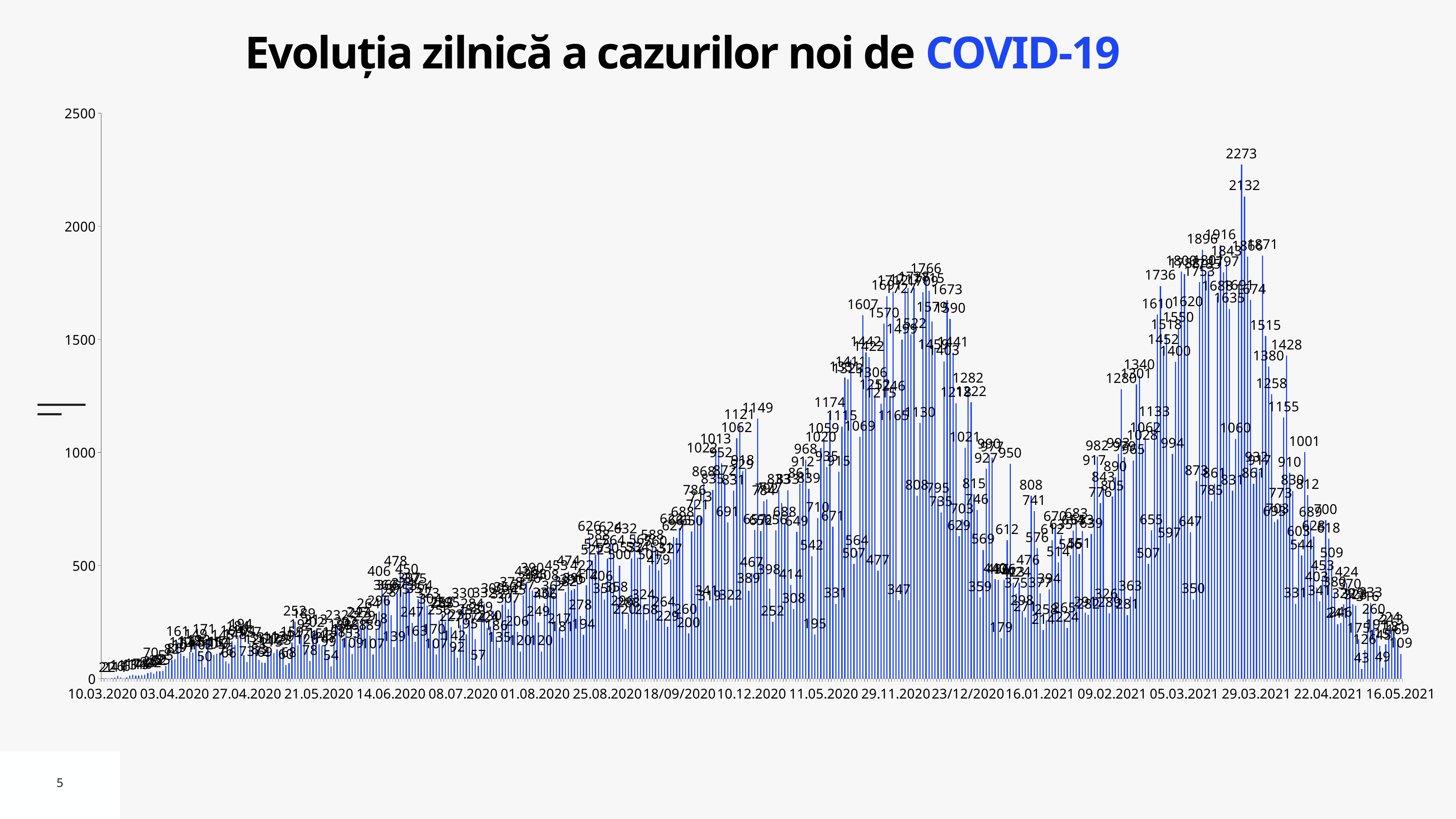
What is the highest daily value labelled on the chart? 2273 What is the second highest value labelled on the chart, next to the 2273 peak? 2132 Is the highest value on the chart greater or less than 2000? greater Is the value for the last bar on the chart (16.05.2021) greater or less than 500? less What kind of chart is shown on the slide? bar chart Do the values rise or fall between 10.03.2020 and 21.05.2020? rise Which of the two is larger: the peak value 2273 or the value 1766? 2273 What is the first date label on the horizontal axis? 10.03.2020 What is the difference between the two highest labelled values, 2273 and 2132? 141 What is the last date label on the horizontal axis? 16.05.2021 What is the title of the chart? Evoluția zilnică a cazurilor noi de COVID-19 What is the highest tick value shown on the vertical axis? 2500